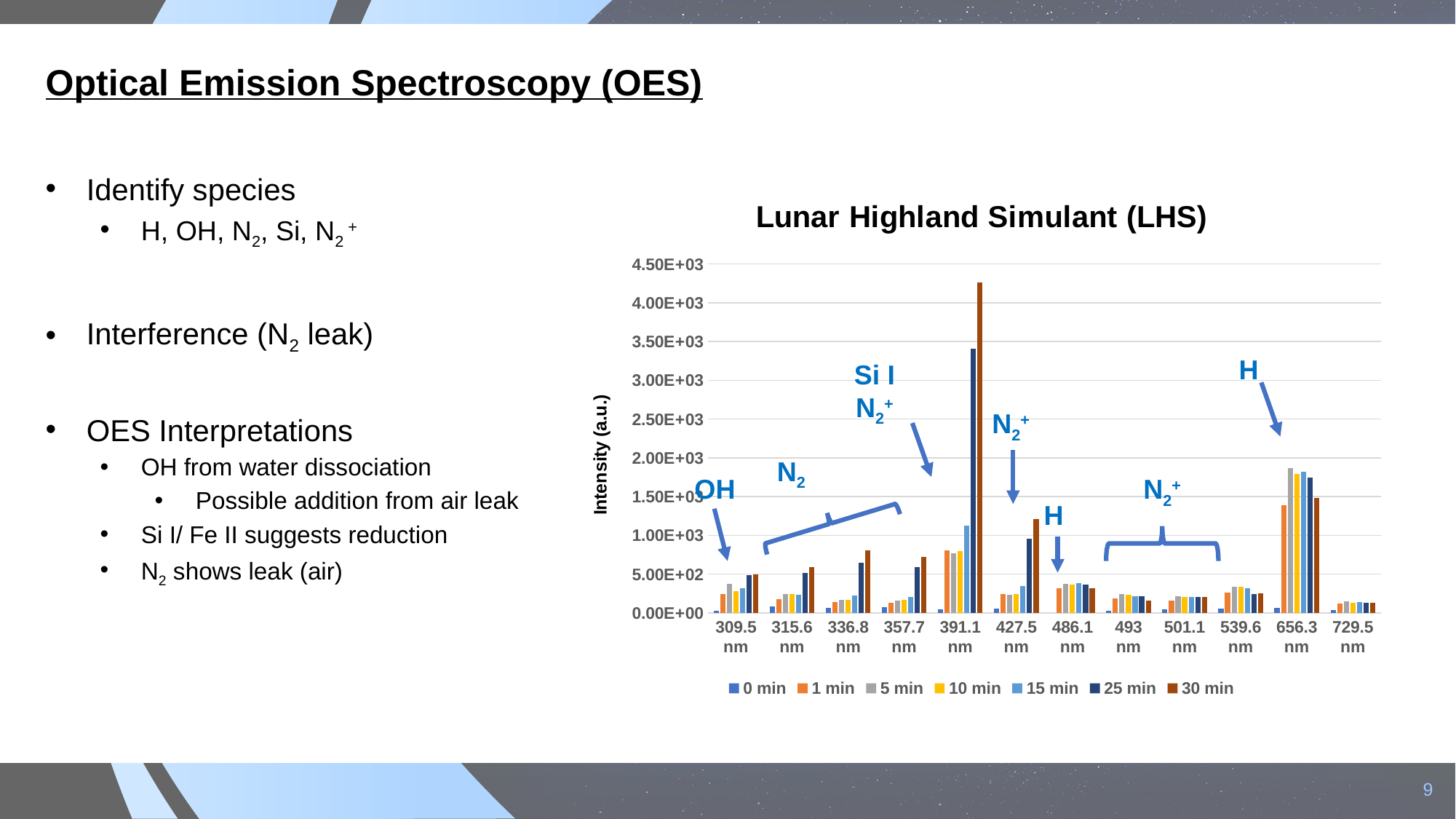
At which wavelength does the chart reach its highest intensity value? 391.1 nm Which is larger: the 30 min value at 391.1 nm or the 30 min value at 656.3 nm? 391.1 nm Is the 25 min value at 391.1 nm greater or less than 3.00E+03? greater How many series does the chart legend list? 7 Which series has the highest value at 391.1 nm? 30 min How many wavelength categories are shown on the x axis of the chart? 12 Is the 0 min value at 391.1 nm greater or less than 5.00E+02? less Is the 30 min value at 391.1 nm greater or less than 4.00E+03? greater What kind of chart is shown on the slide? bar chart What is the label of the y axis of the chart? Intensity (a.u.) What is the title of the chart? Lunar Highland Simulant (LHS)